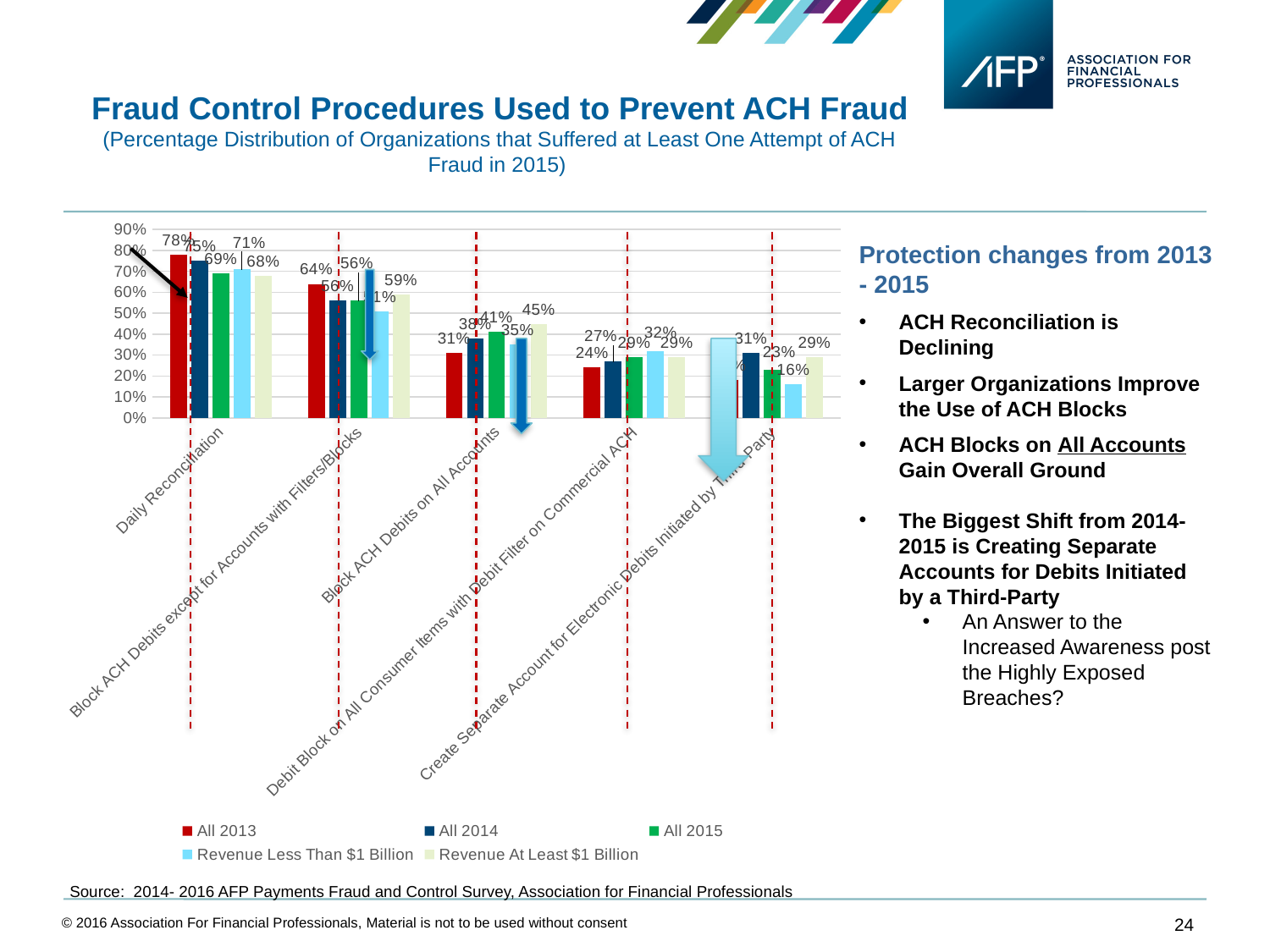
Which series has the lowest value for Daily Reconciliation? Revenue At Least $1 Billion What is the All 2014 value for Debit Block on All Consumer Items with Debit Filter on Commercial ACH? 27% What kind of chart is shown on the slide? Bar chart What is the All 2013 value for Daily Reconciliation? 78% From All 2013 to All 2014 to All 2015, does the value for Daily Reconciliation rise or fall? Fall Which series has the highest value for Daily Reconciliation? All 2013 How many fraud control procedure categories are shown on the x axis? 5 What is the difference between the All 2013 and All 2015 values for Daily Reconciliation? 9 percentage points What is the Revenue At Least $1 Billion value for Block ACH Debits on All Accounts? 45% How many series does the legend list? 5 What is the Revenue Less Than $1 Billion value for Create Separate Account for Electronic Debits Initiated by Third Party? 16% For Block ACH Debits on All Accounts, which is larger: the All 2014 value or the All 2015 value? All 2015